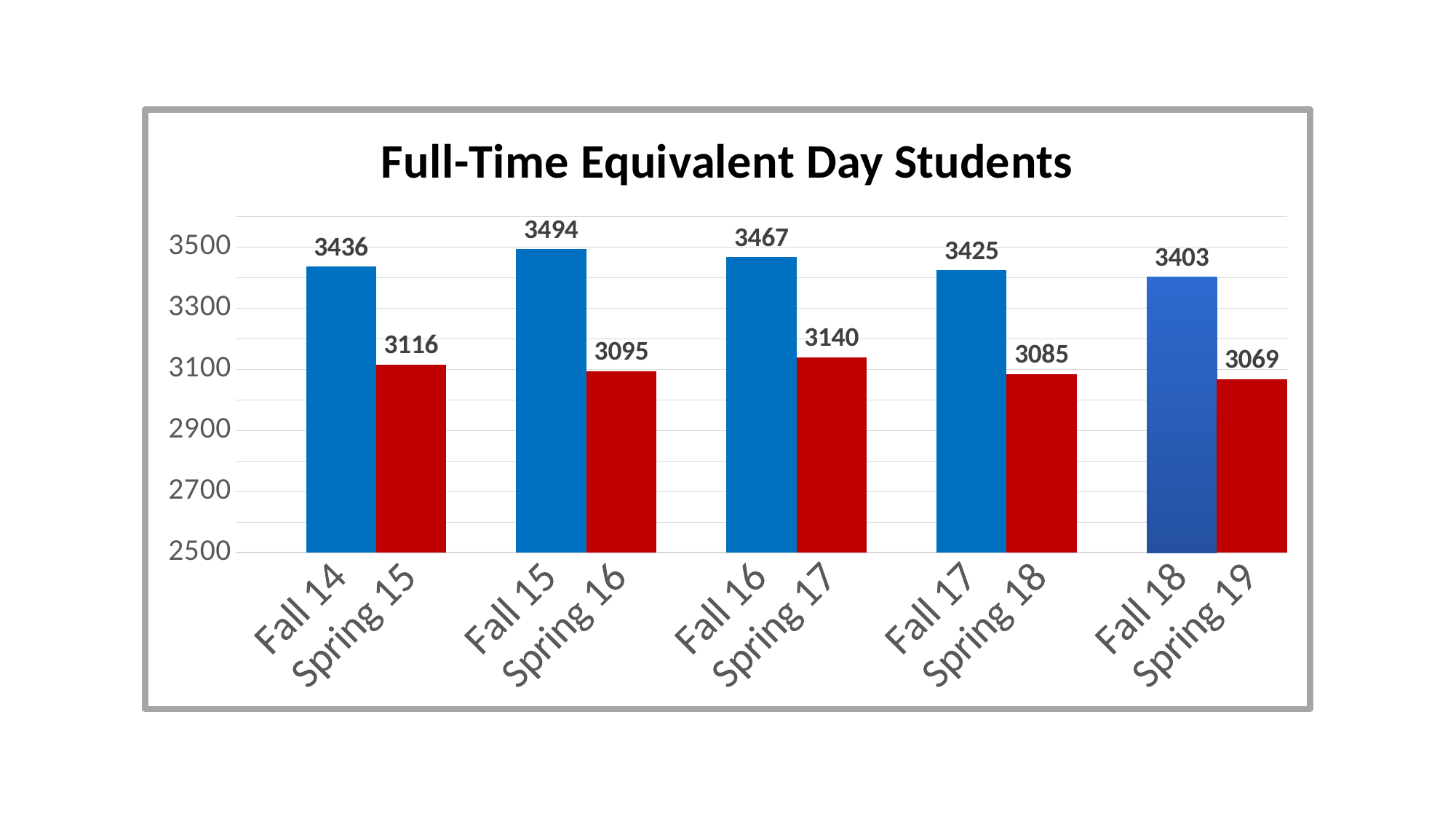
What is the value for Spring 19? 3069 What is the difference between Fall 18 and Fall 15? 91 What is the value for Spring 17? 3140 Is the value for Fall 17 greater or less than 3300? greater What kind of chart is this? bar chart Which term has the lowest value? Spring 19 What is the title of the chart? Full-Time Equivalent Day Students Which is larger, Spring 16 or Spring 18? Spring 16 Which term has the highest value? Fall 15 What is the value for Fall 15? 3494 What is the difference between Fall 14 and Spring 15? 320 How many bars are shown in the chart? 10